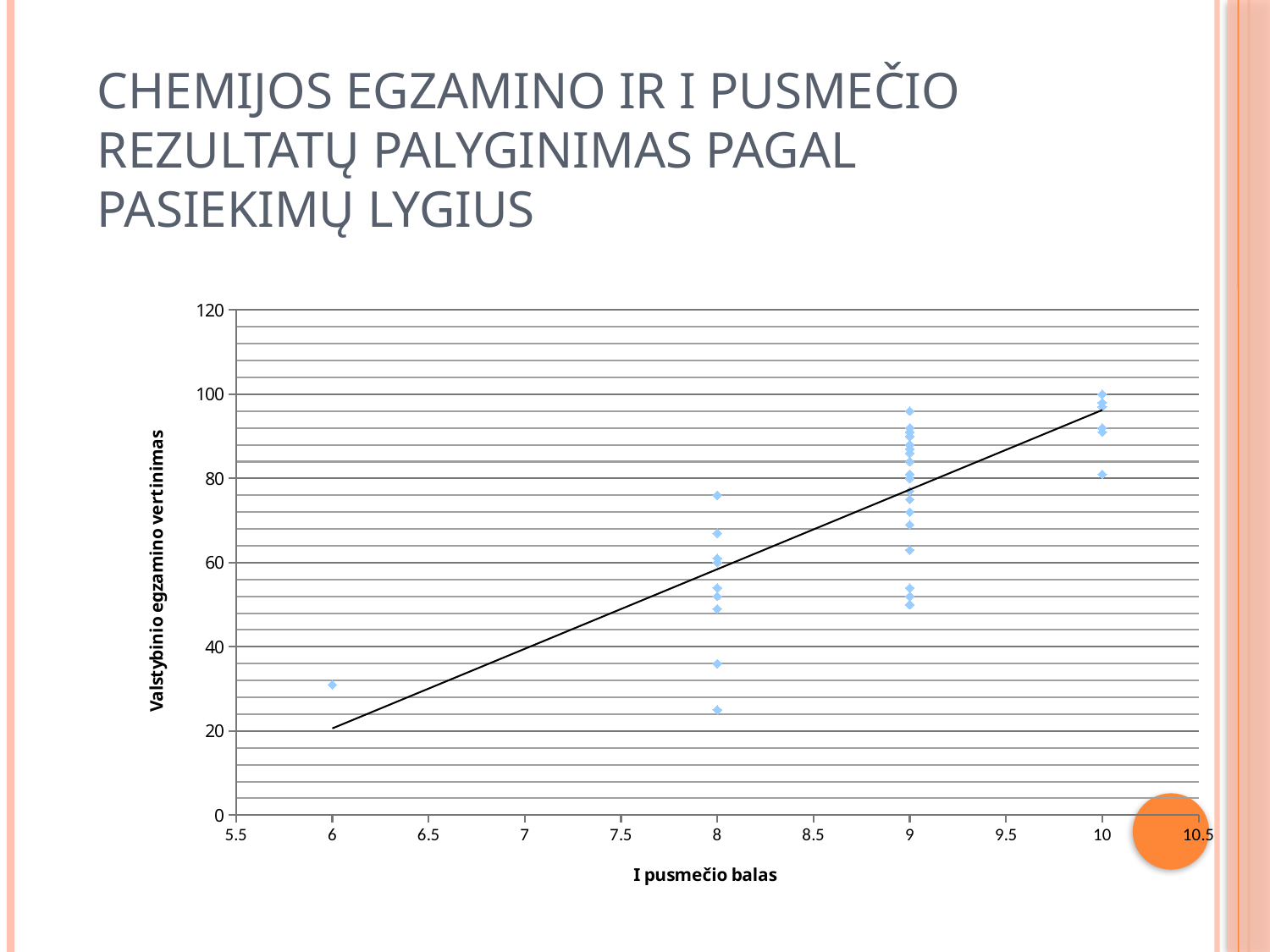
Is the lowest point at I pusmečio balas 10 greater or less than 60? greater What kind of chart is shown on the slide? scatter chart Which is higher: the point at I pusmečio balas 6 or the highest point at I pusmečio balas 8? the highest point at 8 Which I pusmečio balas value has the most plotted points? 9 What is the title of the y axis of the chart? Valstybinio egzamino vertinimas Is the exam value for the point at I pusmečio balas 6 greater or less than 40? less How many distinct I pusmečio balas values have plotted points? 4 Does the trend line rise or fall as the I pusmečio balas increases? rises Is the lowest point at I pusmečio balas 8 greater or less than 40? less What is the title of the x axis of the chart? I pusmečio balas